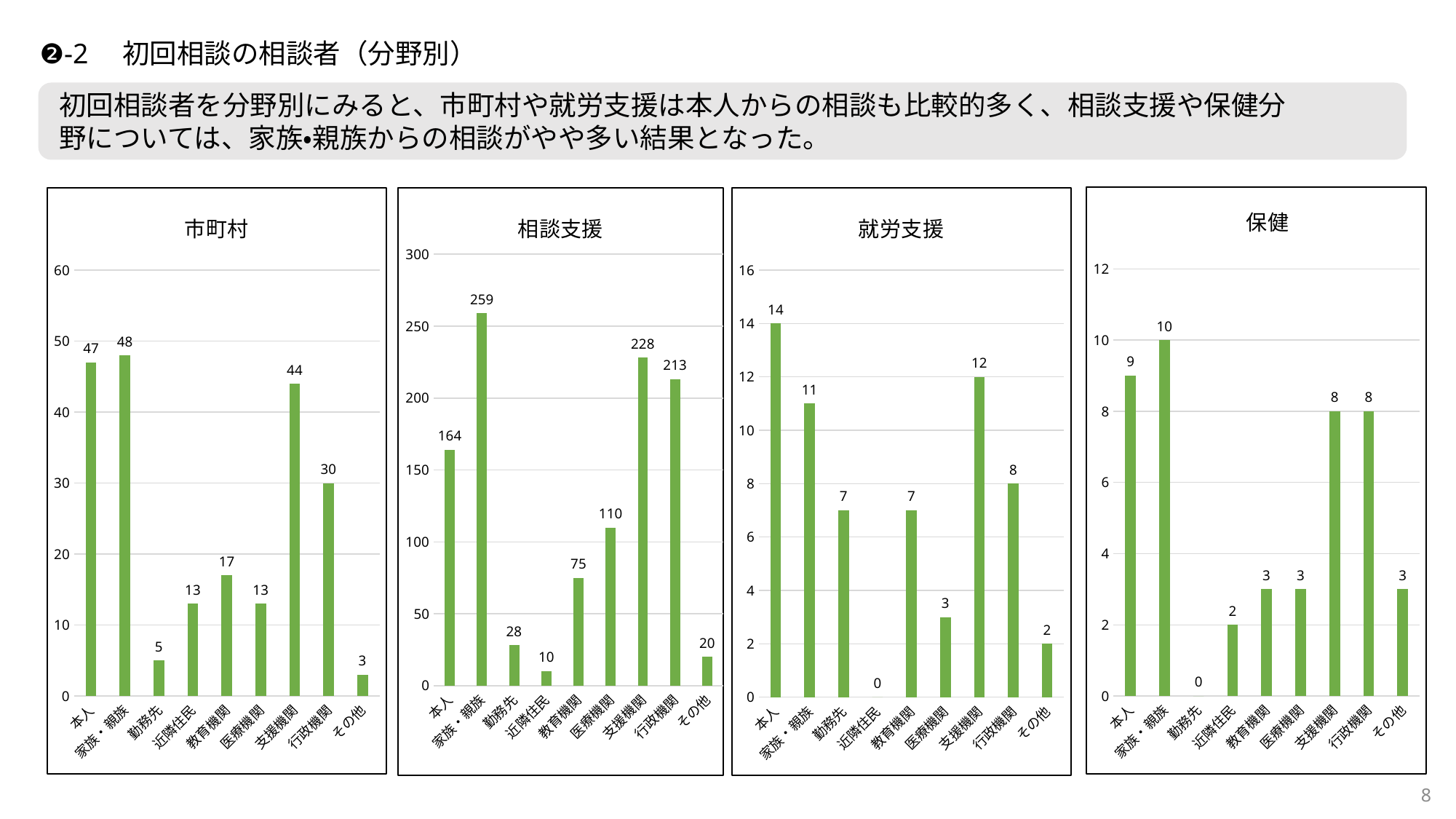
How many categories are shown in the 就労支援 chart? 9 In the 保健 chart, what is the difference between 家族・親族 and 本人? 1 In the 就労支援 chart, what is the value for 支援機関? 12 In the 相談支援 chart, which category has the highest value? 家族・親族 In the 就労支援 chart, which category has the lowest value? 近隣住民 In the 相談支援 chart, what is the difference between 家族・親族 and 本人? 95 How many charts are shown on the slide? 4 In the 市町村 chart, what is the value for 本人? 47 What kind of chart is the 保健 chart? bar chart In the 相談支援 chart, what is the value for 支援機関? 228 In the 保健 chart, what is the value for 勤務先? 0 In the 市町村 chart, which is larger, 支援機関 or 行政機関? 支援機関